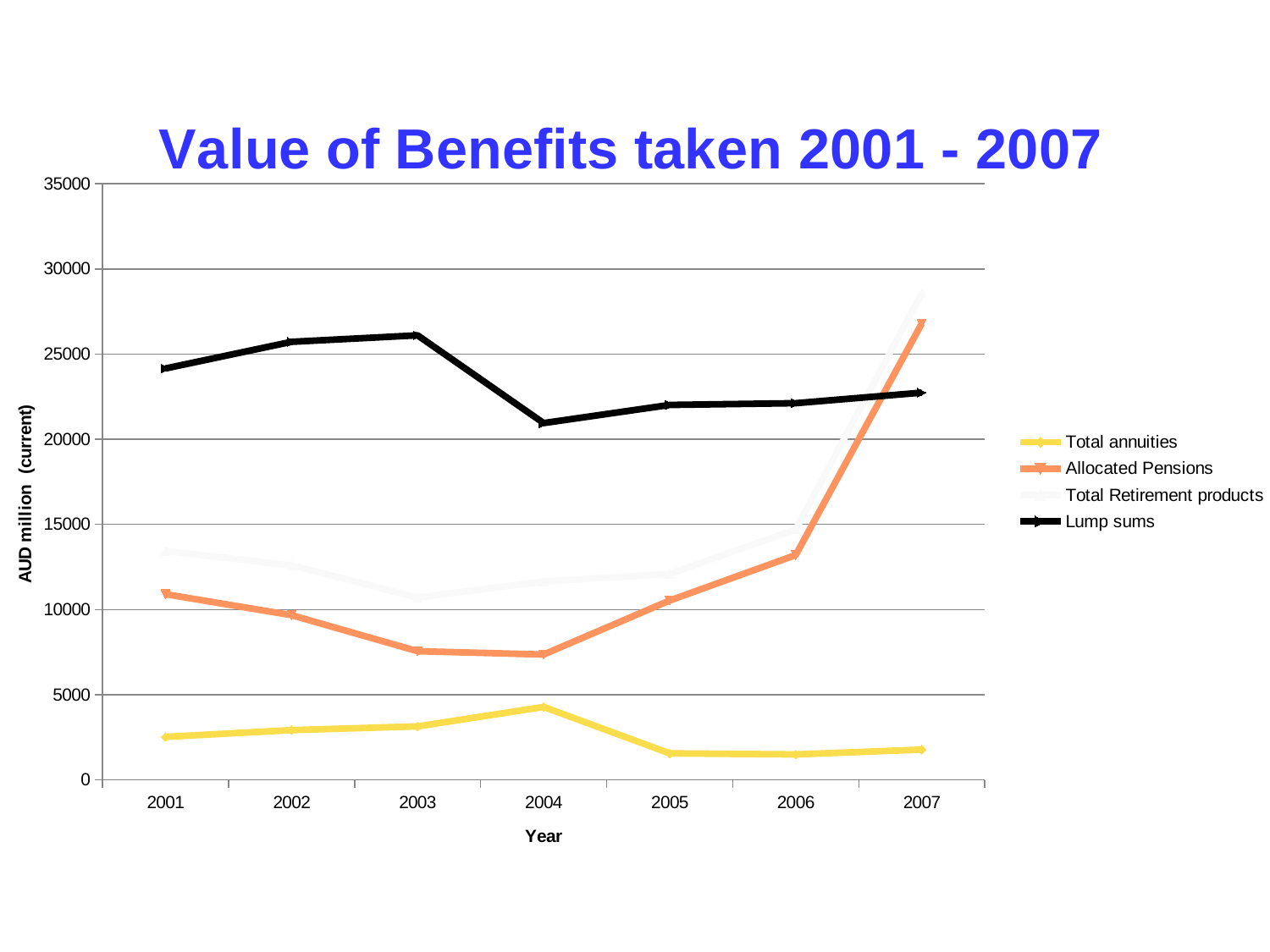
In which year is the value for Total annuities highest? 2004 What is the label on the vertical axis? AUD million (current) Is the value for Total annuities in 2004 greater or less than 5000? less What kind of chart is shown on the slide? Line chart How many series does the legend list? 4 Is the value for Allocated Pensions in 2004 greater or less than 10000? less Is the value for Allocated Pensions in 2007 greater or less than 25000? greater Which is larger in 2007, Allocated Pensions or Lump sums? Allocated Pensions What is the title of the chart? Value of Benefits taken 2001 - 2007 Which series has the highest value in 2001? Lump sums How many years are plotted along the x axis? 7